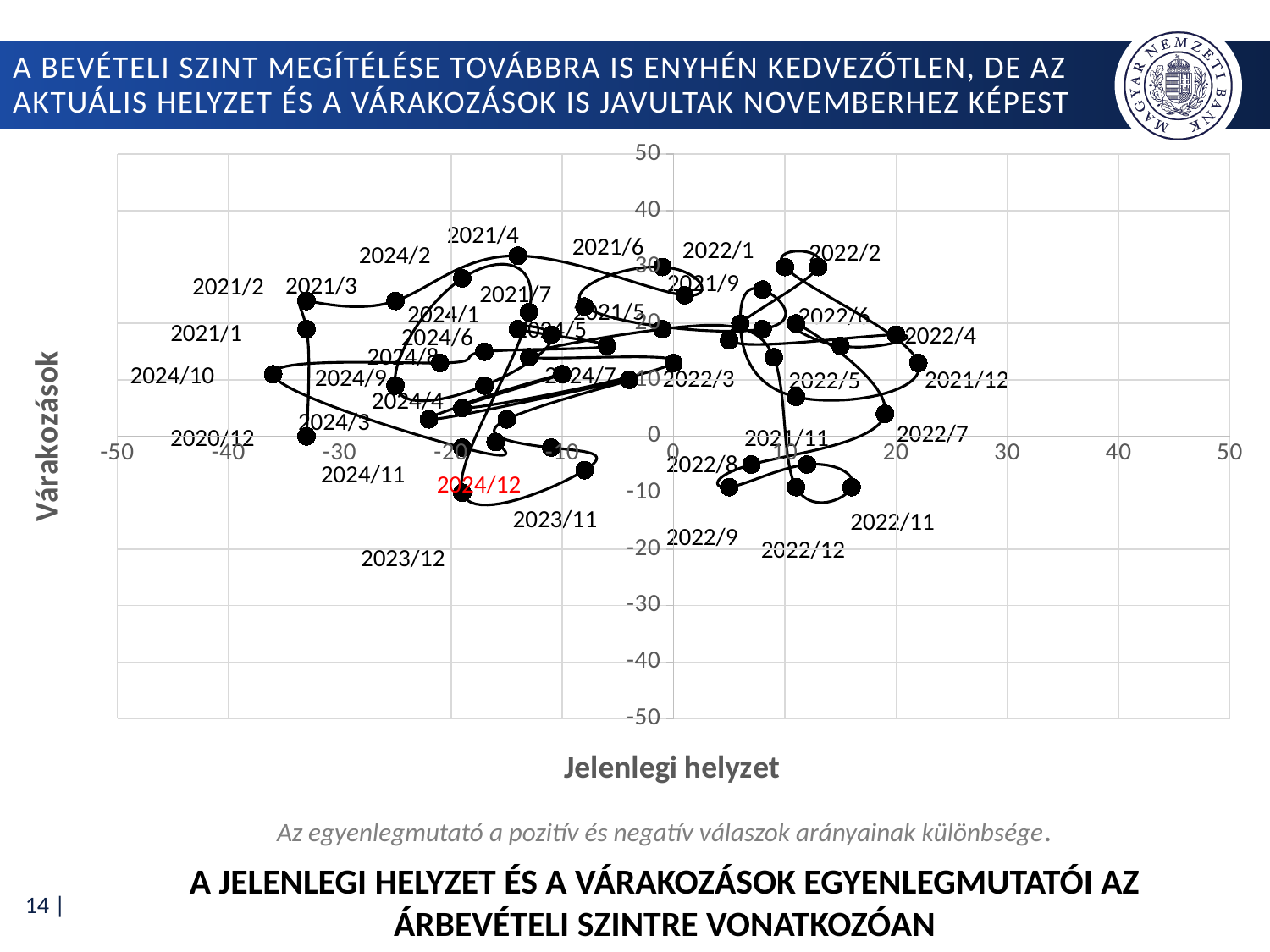
Which point has the higher Várakozások value, 2022/2 or 2024/12? 2022/2 Which data point label is printed in red on the chart? 2024/12 Is the Várakozások value for the 2022/11 point greater or less than 0? less Is the Jelenlegi helyzet value for the 2024/10 point greater or less than -30? less What is the title of the horizontal axis of the chart? Jelenlegi helyzet What kind of chart is shown on the slide? scatter chart What is the title of the vertical axis of the chart? Várakozások Is the Várakozások value for the 2021/4 point greater or less than 20? greater Which point has the higher Jelenlegi helyzet value, 2021/12 or 2024/10? 2021/12